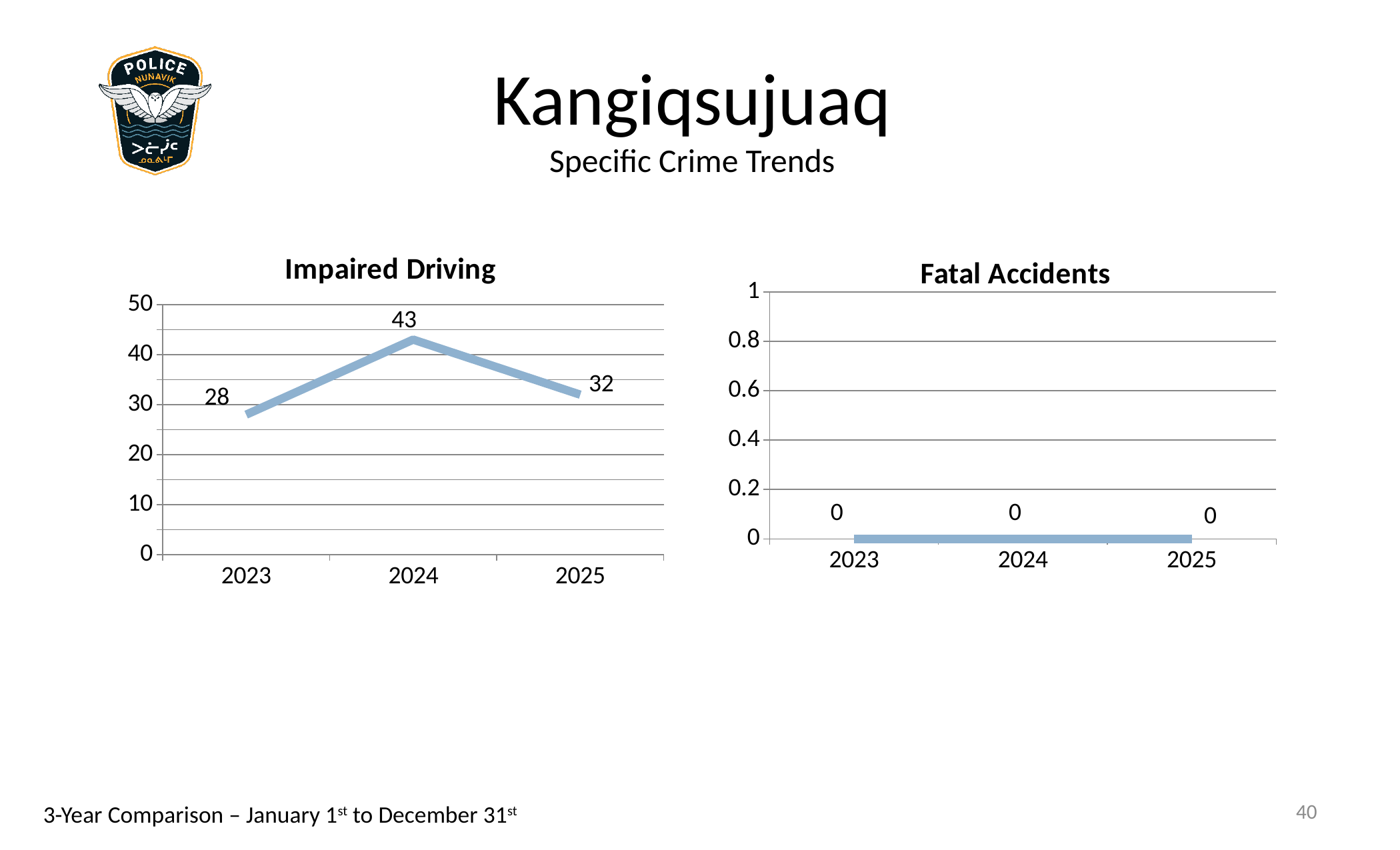
In the Impaired Driving chart, what is the value for 2025? 32 In the Impaired Driving chart, what is the value for 2024? 43 In the Impaired Driving chart, which year has the highest value? 2024 In the Impaired Driving chart, which is larger, the value for 2025 or the value for 2023? 2025 In the Impaired Driving chart, what is the value for 2023? 28 In the Impaired Driving chart, how many years are plotted? 3 In the Fatal Accidents chart, what is the value for 2024? 0 In the Impaired Driving chart, what is the difference between the 2024 and 2023 values? 15 In the Impaired Driving chart, which year has the lowest value? 2023 What kind of chart is the Impaired Driving chart? Line chart In the Impaired Driving chart, does the value rise or fall from 2024 to 2025? Fall What is the title of the chart on the right side of the slide? Fatal Accidents